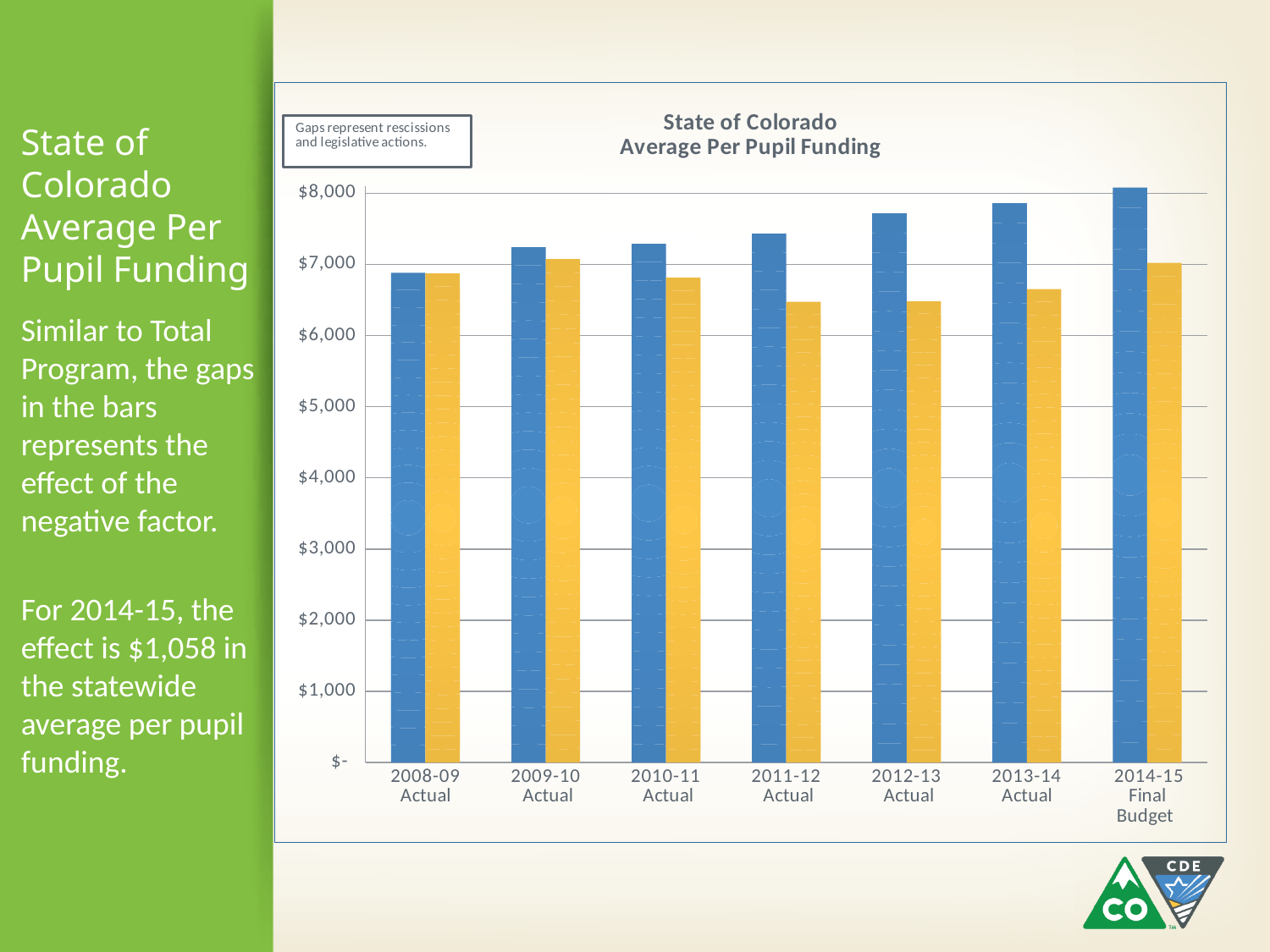
Is the blue bar for 2014-15 Final Budget greater or less than $7,000? greater Which category has the tallest blue bar? 2014-15 Final Budget Is the yellow bar for 2011-12 Actual greater or less than $7,000? less Do the blue bars rise or fall from 2008-09 Actual to 2014-15 Final Budget? rise Is the blue bar for 2008-09 Actual greater or less than $7,000? less Which category has the shortest blue bar? 2008-09 Actual For 2011-12 Actual, which bar is taller, the blue bar or the yellow bar? the blue bar How many school-year categories are shown on the x axis of the chart? 7 What kind of chart is shown on the slide? bar chart What is the title of the chart? State of Colorado Average Per Pupil Funding